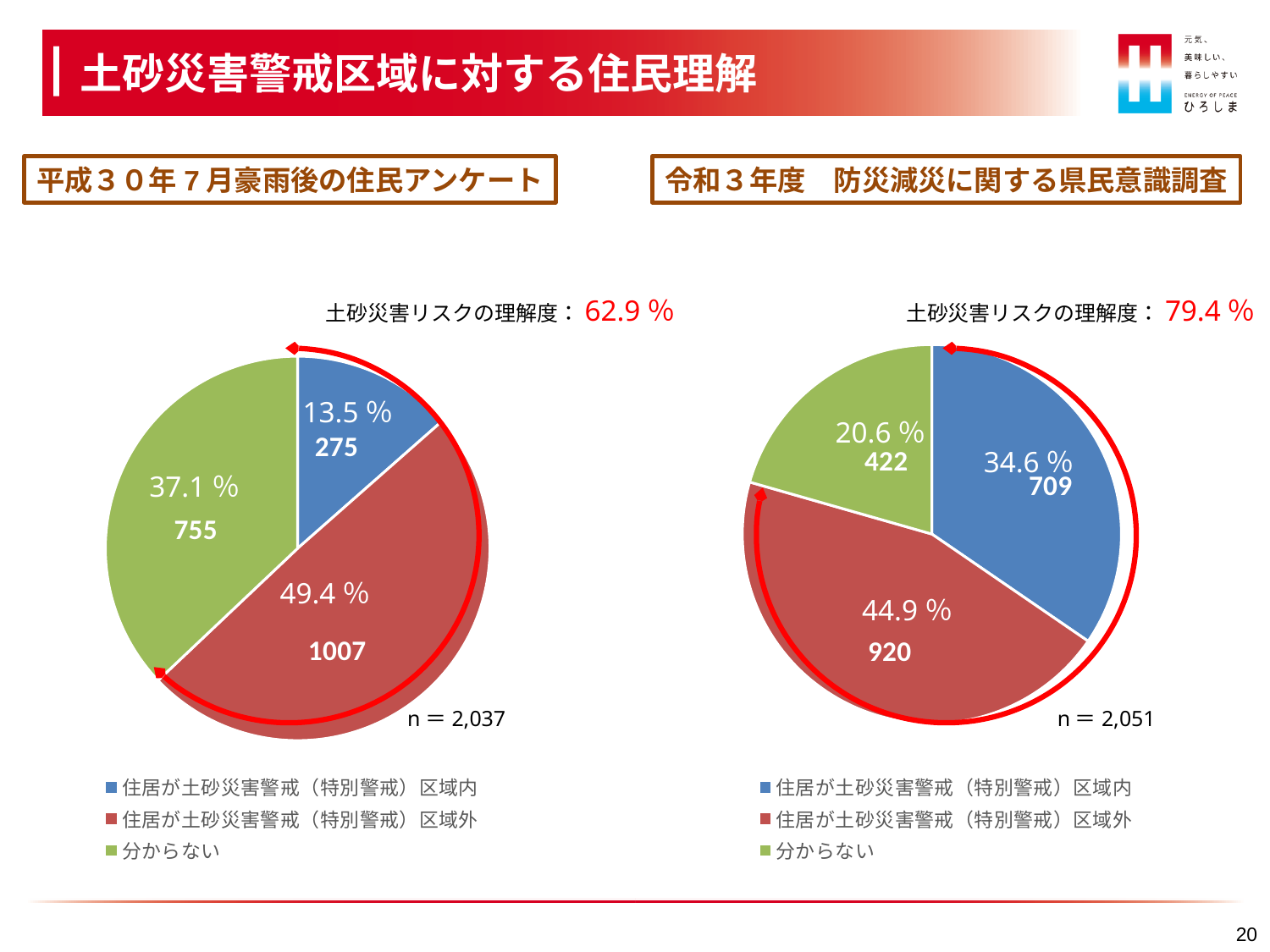
In the right pie chart (令和3年度 防災減災に関する県民意識調査), which category has the smallest slice? 分からない In the right pie chart (令和3年度 防災減災に関する県民意識調査), what percentage is shown for 住居が土砂災害警戒（特別警戒）区域内? 34.6 % Which chart shows a larger percentage for 住居が土砂災害警戒（特別警戒）区域内, the left (平成30年) or the right (令和3年度)? The right (令和3年度) What kind of chart is used on the left side of the slide (平成30年7月豪雨後の住民アンケート)? Pie chart In the right pie chart (令和3年度 防災減災に関する県民意識調査), what count is shown for 住居が土砂災害警戒（特別警戒）区域外? 920 In the left pie chart (平成30年7月豪雨後の住民アンケート), which category has the largest slice? 住居が土砂災害警戒（特別警戒）区域外 How many categories does the legend of the left pie chart list? 3 In the left pie chart (平成30年7月豪雨後の住民アンケート), what count is shown for 分からない? 755 In the left pie chart (平成30年7月豪雨後の住民アンケート), what percentage is shown for 住居が土砂災害警戒（特別警戒）区域内? 13.5 % In the left pie chart (平成30年7月豪雨後の住民アンケート), which category has the smallest slice? 住居が土砂災害警戒（特別警戒）区域内 What is the sample size (n) shown for the right pie chart (令和3年度 防災減災に関する県民意識調査)? 2,051 In the right pie chart (令和3年度 防災減災に関する県民意識調査), what is the difference in counts between 住居が土砂災害警戒（特別警戒）区域外 and 住居が土砂災害警戒（特別警戒）区域内? 211